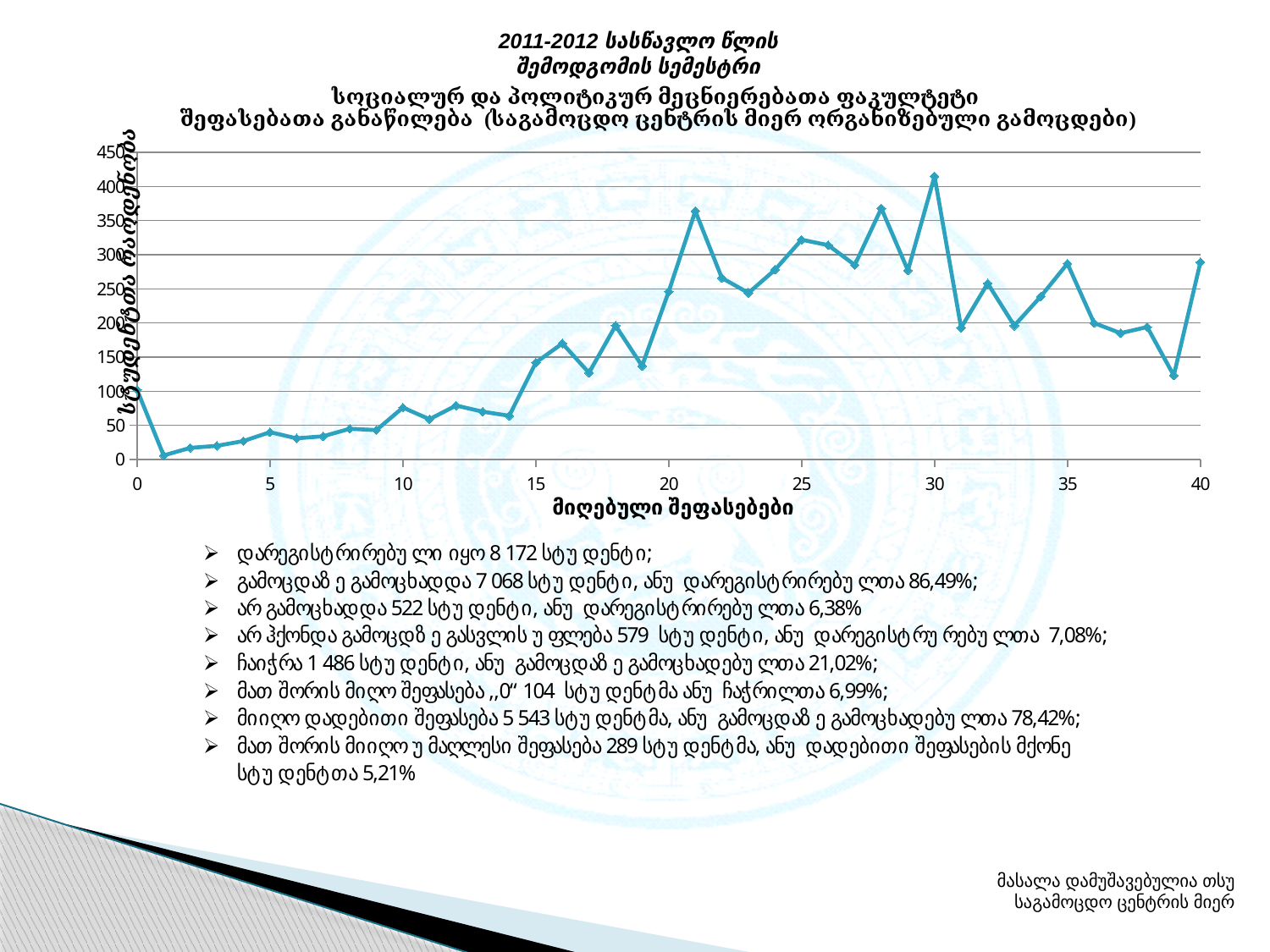
Is the value at x = 10 greater or less than 100? less What is the title of the x axis? მიღებული შეფასებები Is the value at x = 30 greater or less than 350? greater At which x-axis value (grade) does the line reach its lowest point? 1 Which has the larger value: the point at x = 21 or the point at x = 10? x = 21 At which x-axis value (grade) does the line reach its highest point? 30 Is the value at x = 1 greater or less than 50? less Do the values generally rise or fall as the x-axis value increases from 0 to 40? rise What kind of chart is shown on the slide? line chart What is the highest tick value shown on the y axis? 450